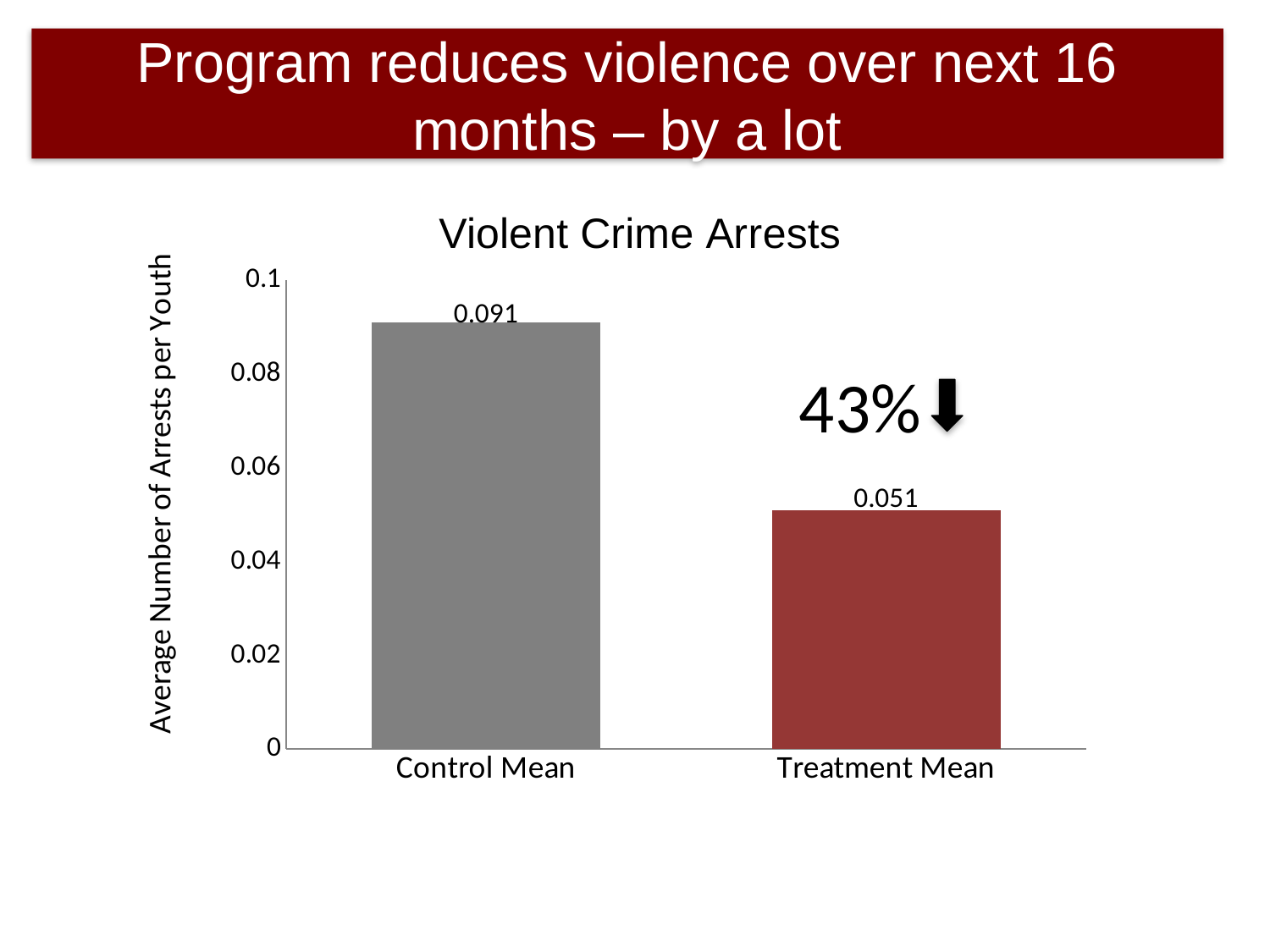
Which category has the highest value? Control Mean Which category has the lowest value? Treatment Mean How many categories are shown on the chart? 2 Which is larger, the Control Mean or the Treatment Mean? Control Mean What is the value for Treatment Mean? 0.051 What kind of chart is shown? bar chart What is the title of the chart? Violent Crime Arrests Is the value for Control Mean greater or less than 0.08? greater What is the difference between the Control Mean and Treatment Mean values? 0.040 What is the value for Control Mean? 0.091 What is the label of the vertical axis? Average Number of Arrests per Youth Is the value for Treatment Mean greater or less than 0.06? less